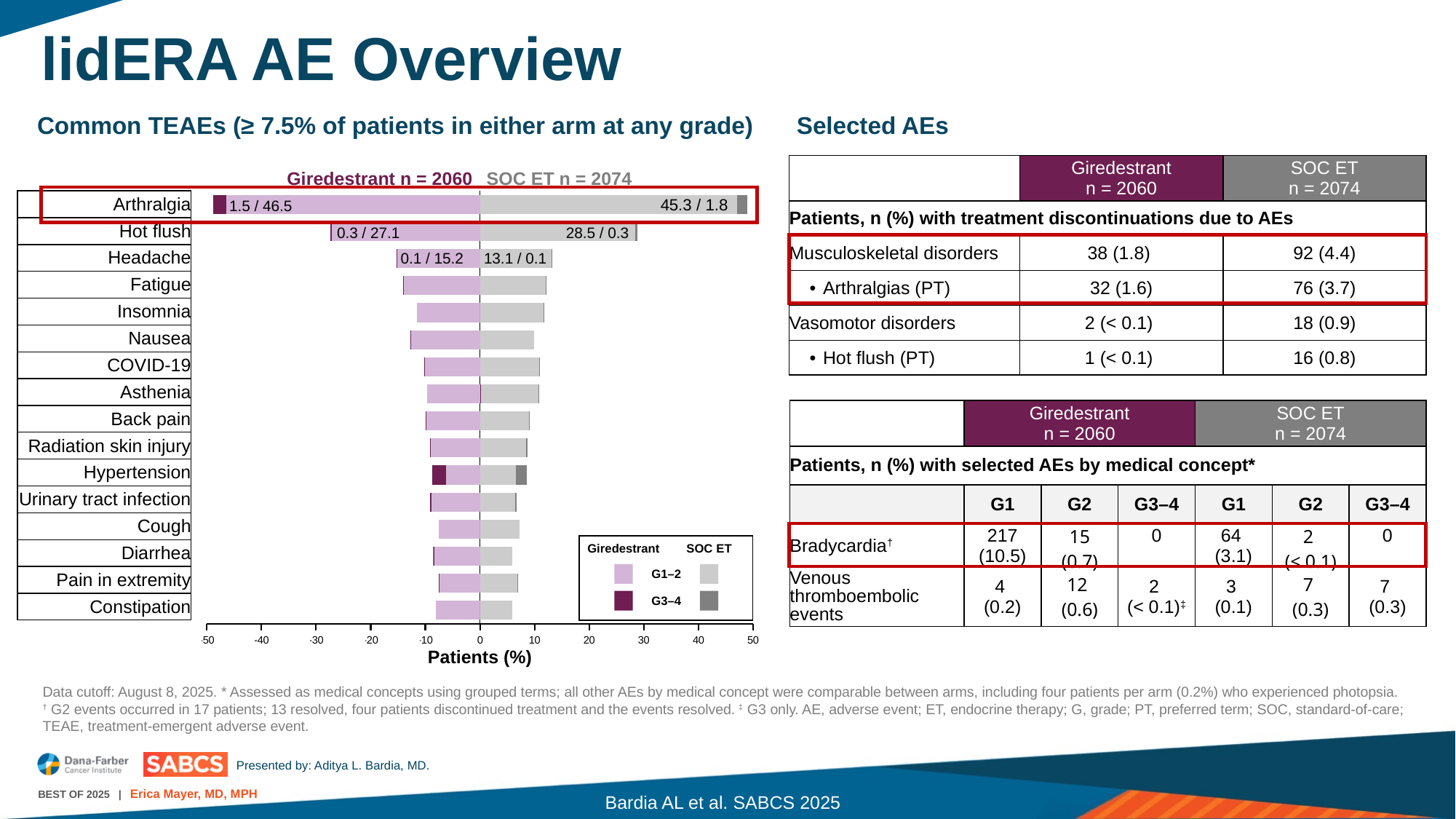
In the common TEAEs chart, what is the Giredestrant G1–2 value for Headache? 15.2 In the common TEAEs chart, is the Giredestrant value for Fatigue greater or less than 10? greater In the common TEAEs chart, what is the SOC ET G1–2 value for Hot flush? 28.5 What kind of chart is used to show the common TEAEs on the slide? bar chart In the common TEAEs chart, which adverse event has the highest Giredestrant G1–2 value? Arthralgia In the common TEAEs chart, what is the Giredestrant G3–4 value for Arthralgia? 1.5 How many adverse event categories are listed on the y axis of the common TEAEs chart? 16 In the common TEAEs chart, which arm has the larger G1–2 value for Hot flush, Giredestrant or SOC ET? SOC ET What is the x-axis title of the common TEAEs chart? Patients (%) In the common TEAEs chart, what is the difference between the Giredestrant G1–2 value and the SOC ET G1–2 value for Headache? 2.1 In the common TEAEs chart, what is the SOC ET G1–2 value for Arthralgia? 45.3 In the common TEAEs chart, what is the Giredestrant G1–2 value for Arthralgia? 46.5